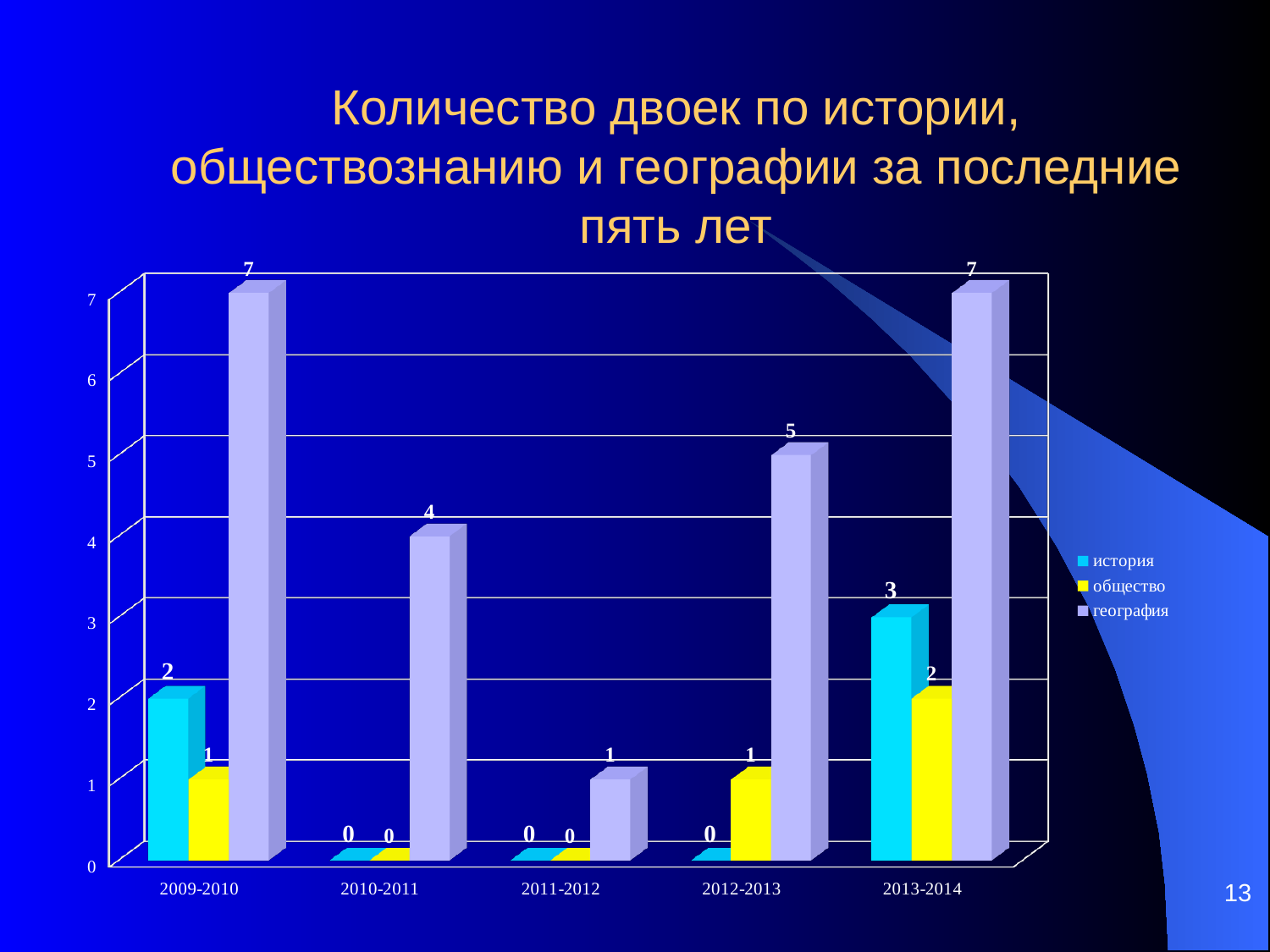
How many series does the legend list? 3 Does the value for география rise or fall from 2011-2012 to 2012-2013? rise Which series is shown in yellow in the legend? общество What is the value for география in 2010-2011? 4 What is the difference between география and история in 2009-2010? 5 What is the value for общество in 2012-2013? 1 How many school-year categories are shown on the x axis? 5 What type of chart is shown on the slide? bar chart What is the value for история in 2013-2014? 3 Which is larger in 2013-2014: история or общество? история In which year is the value for история the highest? 2013-2014 In which year is the value for география the lowest? 2011-2012